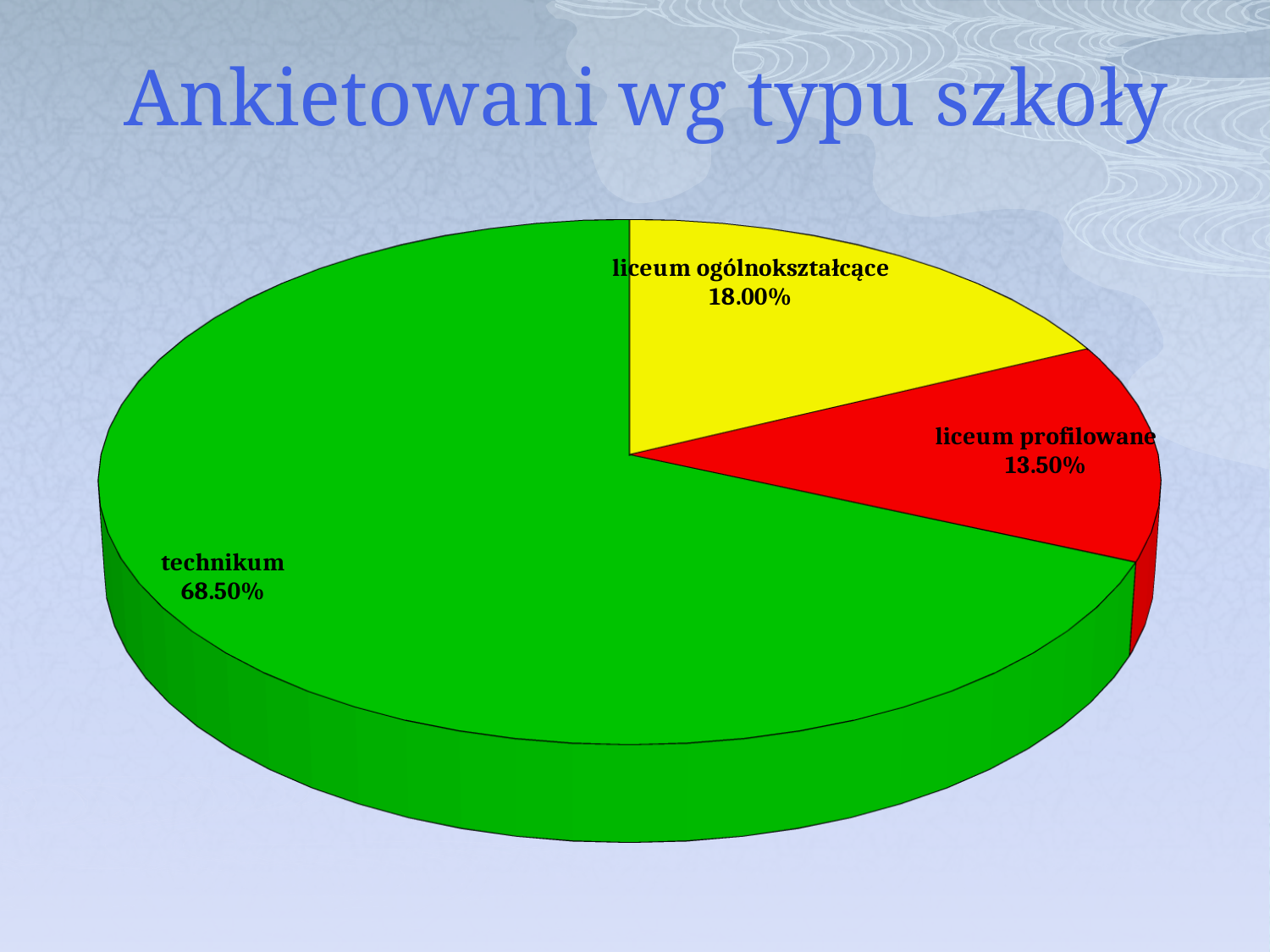
Which school type has the smallest share of respondents? liceum profilowane Which has a larger share, liceum ogólnokształcące or liceum profilowane? liceum ogólnokształcące What share of respondents attend liceum profilowane? 13.50% What is the difference in percentage points between technikum and liceum ogólnokształcące? 50.50 What is the title of the chart? Ankietowani wg typu szkoły What share of respondents attend technikum? 68.50% What share of respondents attend liceum ogólnokształcące? 18.00% What kind of chart is shown on the slide? pie chart Which school type has the largest share of respondents? technikum What is the difference in percentage points between liceum ogólnokształcące and liceum profilowane? 4.50 What colour is the technikum slice? green How many school types are shown in the pie chart? 3